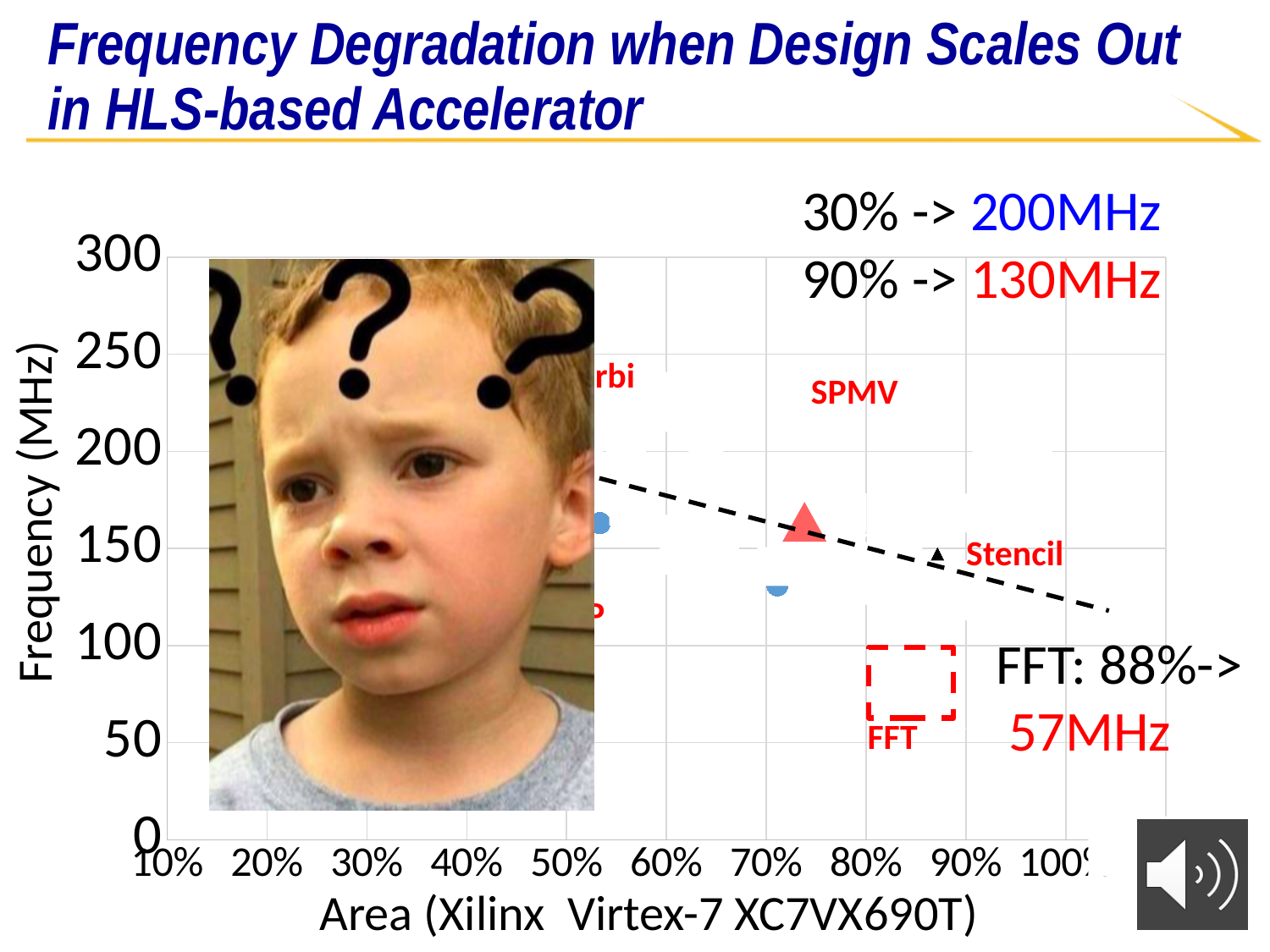
Which has the higher frequency, SPMV or FFT? SPMV According to the dashed trend line, does frequency rise or fall as area increases? fall What is the difference between the annotated frequency at 30% area and at 90% area? 70MHz What is the title of the x axis of the chart? Area (Xilinx Virtex-7 XC7VX690T) According to the annotation on the chart, what frequency corresponds to 90% area? 130MHz What is the title of the y axis of the chart? Frequency (MHz) Of the labeled points SPMV, Stencil and FFT, which has the lowest frequency? FFT Is the frequency for Stencil greater or less than 200 MHz? less Is the area for Stencil greater or less than 80%? greater What kind of chart is shown on the slide? scatter chart According to the annotation, what frequency does FFT reach at 88% area? 57MHz According to the annotation on the chart, what frequency corresponds to 30% area? 200MHz